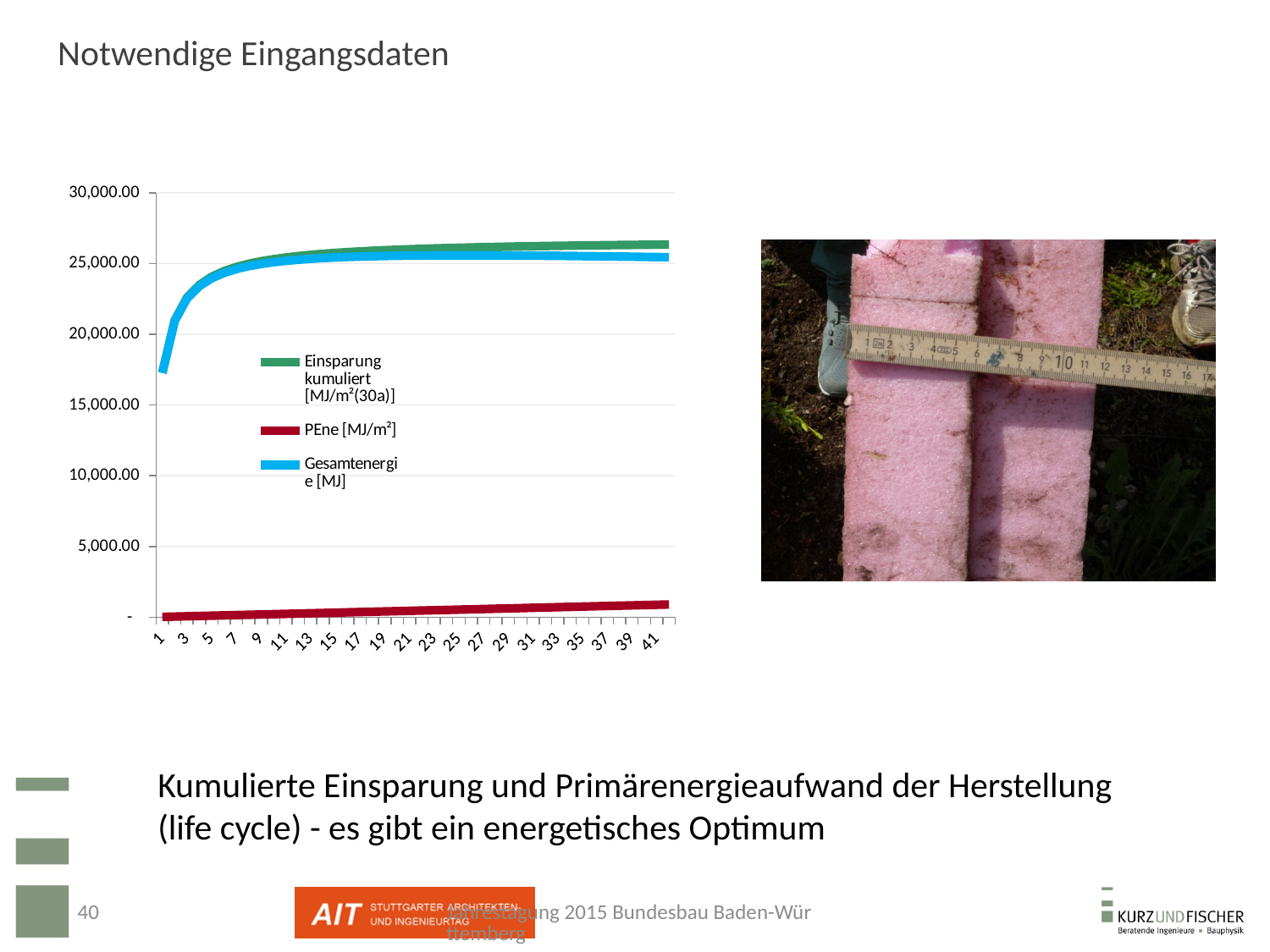
Do the values of the PEne [MJ/m²] series rise or fall along the x axis? rise At x = 21, which is larger: the value of Einsparung kumuliert or the value of PEne [MJ/m²]? Einsparung kumuliert Is the value of Einsparung kumuliert at x = 1 greater or less than 20,000.00? less What is the highest value labelled on the chart's y axis? 30,000.00 Which series in the chart reaches the highest values at the right end of the x axis? Einsparung kumuliert [MJ/m²(30a)] Which series in the chart is drawn in red? PEne [MJ/m²] Which series in the chart has the lowest values across the x axis? PEne [MJ/m²] What kind of chart is shown on the slide? line chart Is the value of Einsparung kumuliert at x = 41 greater or less than 25,000.00? greater Do the values of the Einsparung kumuliert series rise or fall along the x axis? rise How many series does the chart's legend list? 3 Is the value of PEne [MJ/m²] at x = 41 greater or less than 5,000.00? less